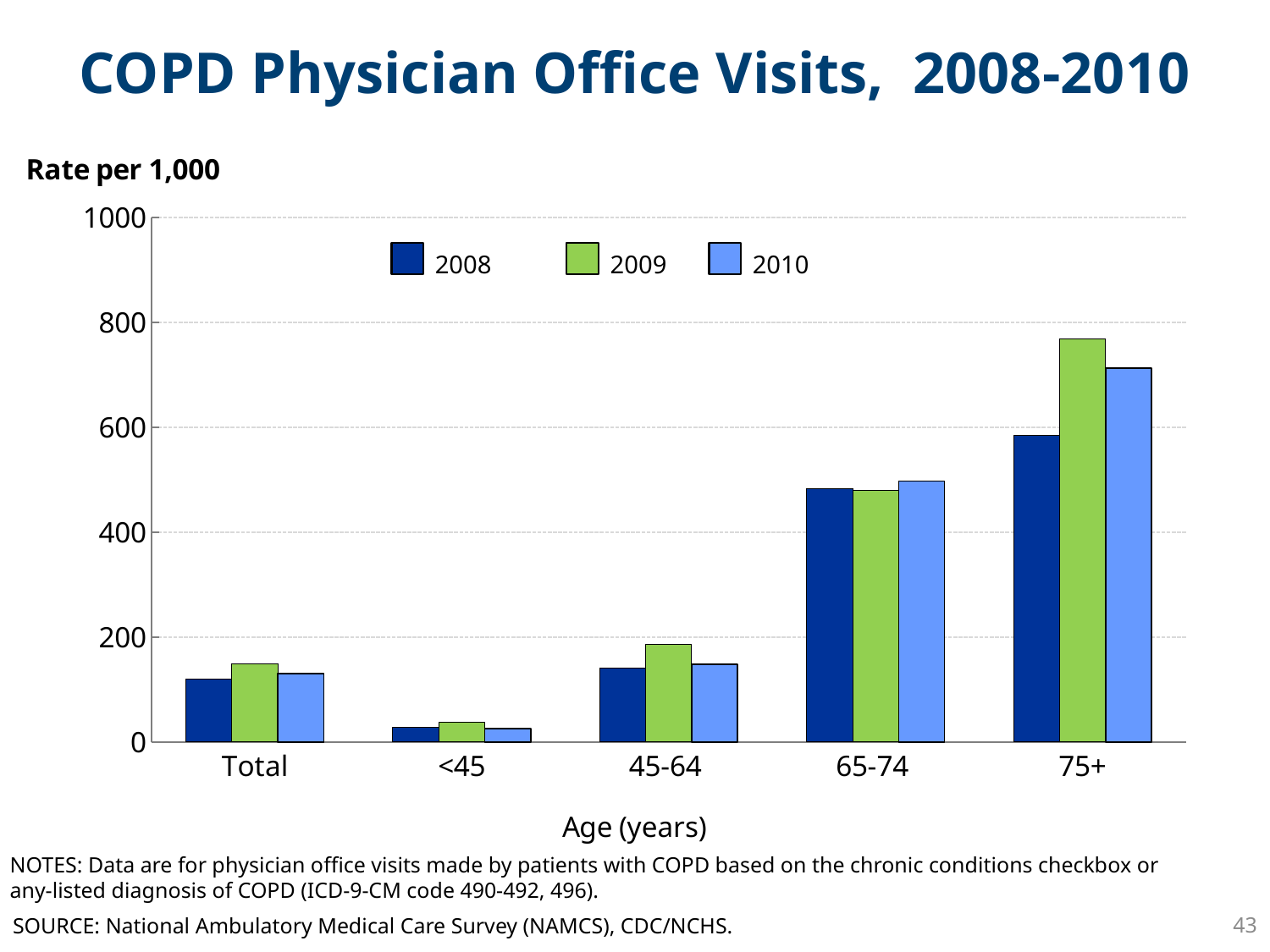
Which age category has the lowest rate for 2008? <45 Is the 2009 value for 75+ greater or less than 600? greater For the 45-64 age group, which year has the larger rate, 2008 or 2009? 2009 Is the 2010 value for <45 greater or less than 200? less For the 75+ age group, which year has the larger rate, 2009 or 2010? 2009 Is the 2008 value for 65-74 greater or less than 400? greater Do the 2009 rates rise or fall as age increases from <45 to 75+? rise What kind of chart is shown on the slide? bar chart How many series does the legend list? 3 How many age categories are shown on the x axis? 5 Which age category has the highest rate for 2009? 75+ What is the label on the x axis of the chart? Age (years)